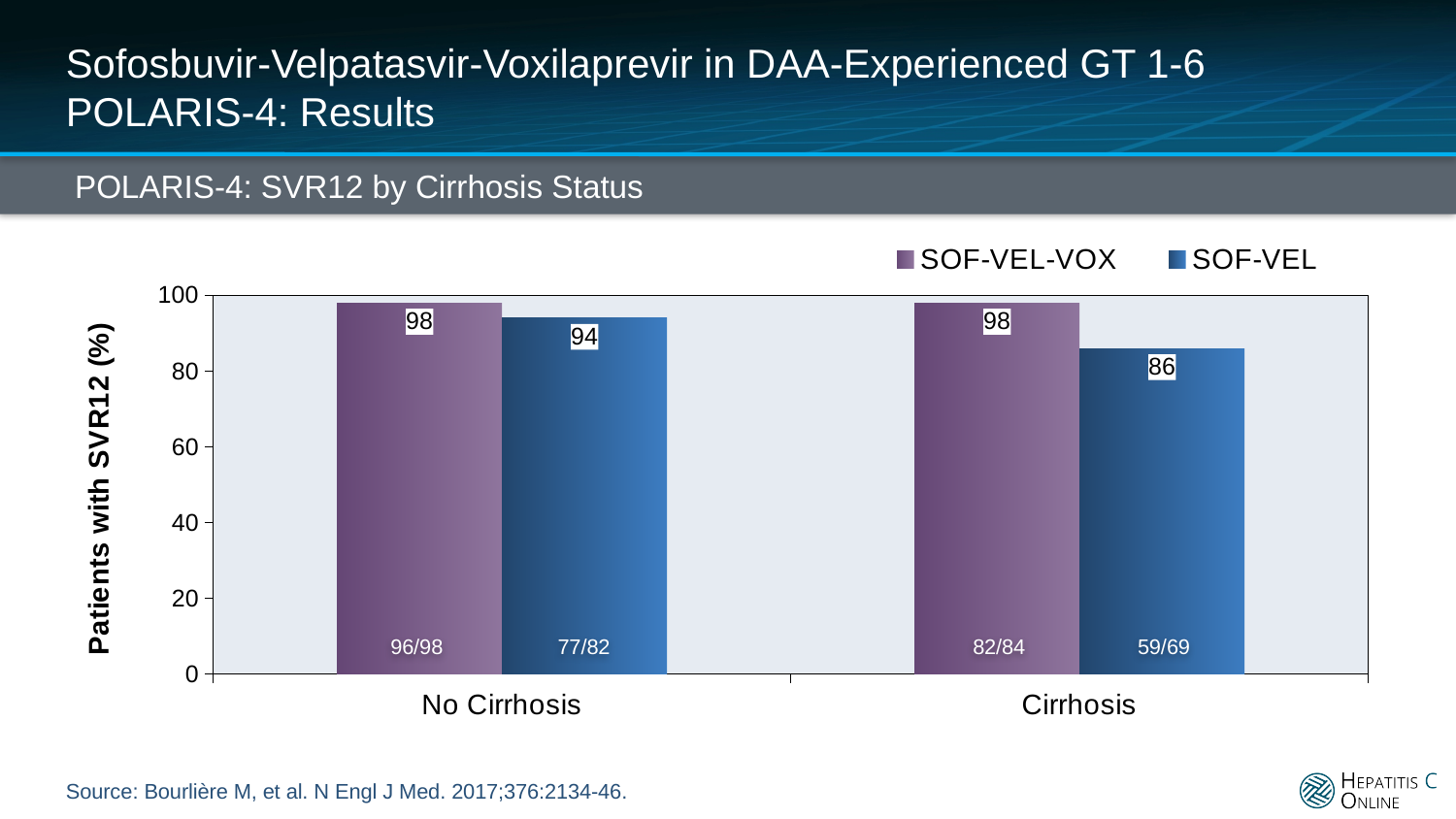
Which bar has the lowest SVR12 rate on the chart? SOF-VEL, Cirrhosis In the No Cirrhosis group, which treatment has the higher SVR12 rate, SOF-VEL-VOX or SOF-VEL? SOF-VEL-VOX What is the SVR12 rate for SOF-VEL in patients with no cirrhosis? 94 What is the label of the y axis? Patients with SVR12 (%) What is the SVR12 rate for SOF-VEL in patients with cirrhosis? 86 What fraction of patients is shown for SOF-VEL in the Cirrhosis group? 59/69 What fraction of patients is shown for SOF-VEL-VOX in the No Cirrhosis group? 96/98 What kind of chart is shown on the slide? Bar chart What is the difference in SVR12 rate between SOF-VEL-VOX and SOF-VEL in the Cirrhosis group? 12 How many categories are shown on the x axis? 2 How many series does the legend list? 2 What is the SVR12 rate for SOF-VEL-VOX in patients with no cirrhosis? 98